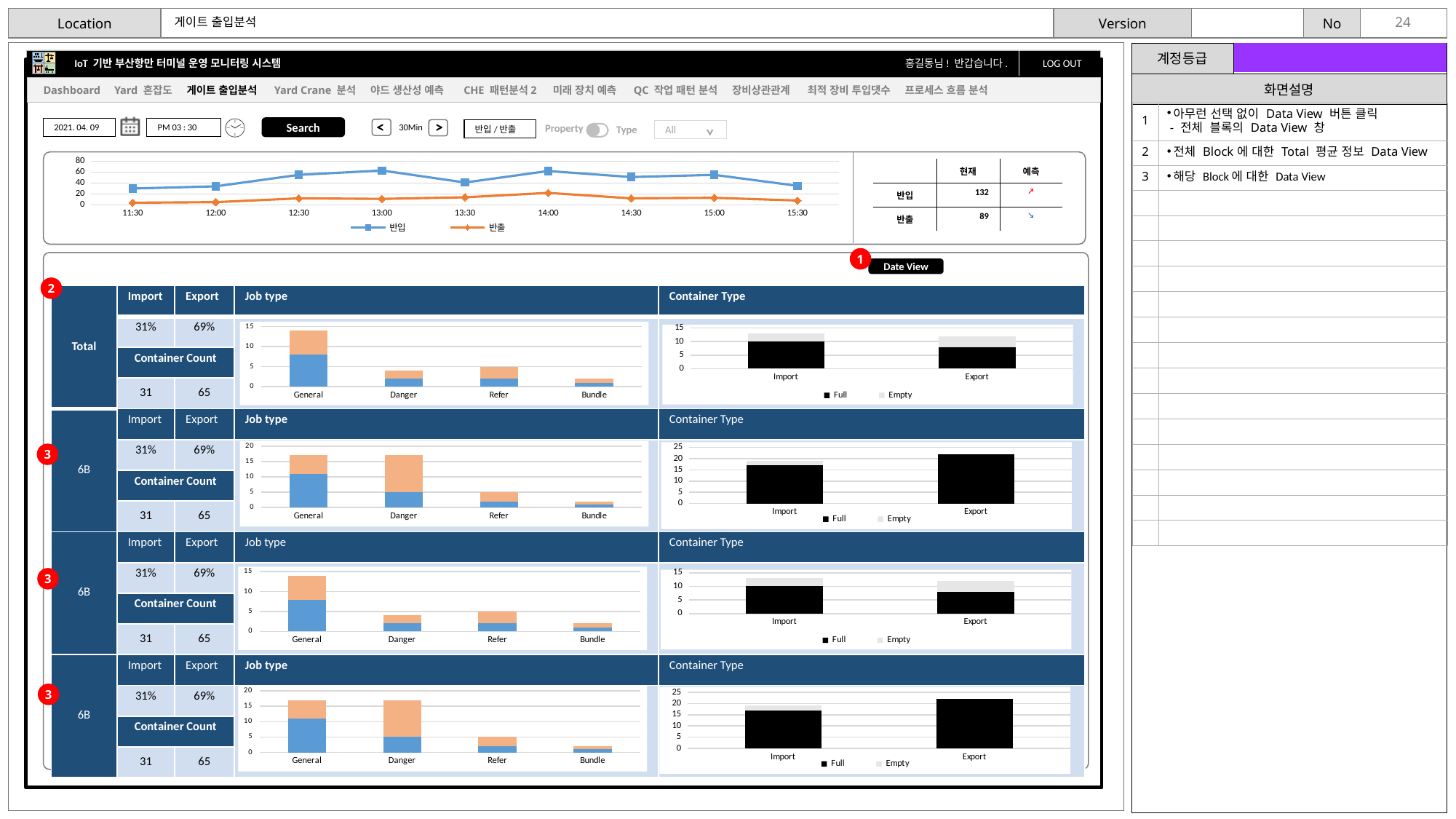
In the first 6B row's Container Type chart, which bar is taller, Import or Export? Export In the Total row's Job type chart, which category has the tallest stacked bar? General In the Total row's Container Type chart, what are the two legend entries? Full, Empty In the Total row's Job type chart, which category has the shortest stacked bar? Bundle In the top line chart, is the value for 반출 at 12:30 greater or less than 20? less In the Total row's Job type chart, is the total for General greater or less than 10? greater In the Total row's Job type chart, how many categories are shown on the x axis? 4 How many series does the legend of the top line chart list? 2 How many time points are plotted along the x axis of the top line chart? 9 What kind of chart is the top chart showing 반입 and 반출 over time? line chart In the top line chart, which series is higher at 14:00, 반입 or 반출? 반입 In the top line chart, is the value for 반입 at 13:00 greater or less than 40? greater